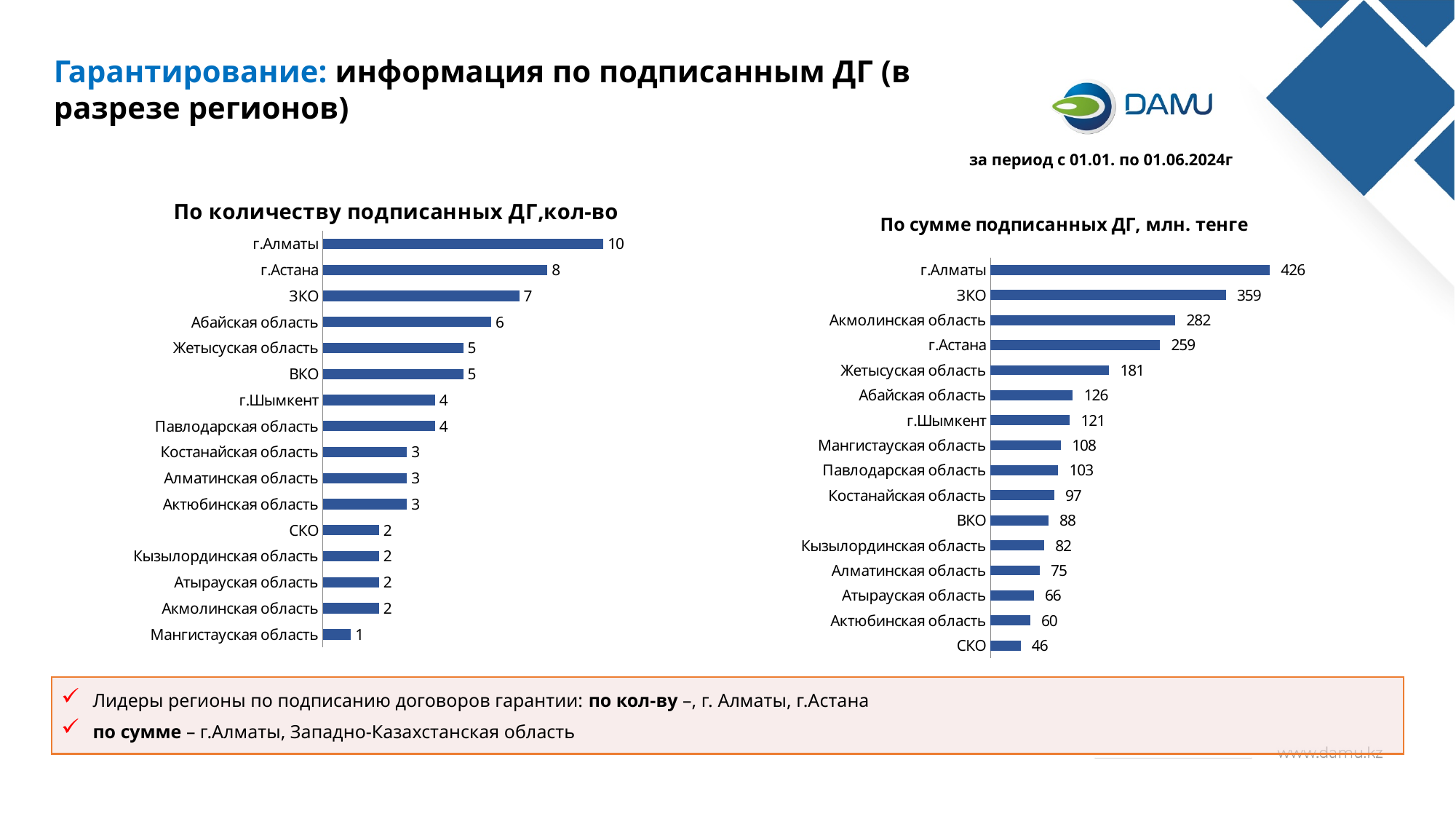
In the chart 'По сумме подписанных ДГ, млн. тенге', which region has the highest value? г.Алматы In the chart 'По сумме подписанных ДГ, млн. тенге', which is larger: Жетысуская область or Абайская область? Жетысуская область How many regions are shown in the chart 'По сумме подписанных ДГ, млн. тенге'? 16 What type of chart is 'По количеству подписанных ДГ,кол-во'? Bar chart In the chart 'По сумме подписанных ДГ, млн. тенге', what is the value for ВКО? 88 In the chart 'По сумме подписанных ДГ, млн. тенге', what is the difference between г.Алматы and ЗКО? 67 In the chart 'По количеству подписанных ДГ,кол-во', which is larger: Абайская область or г.Шымкент? Абайская область In the chart 'По количеству подписанных ДГ,кол-во', what is the difference between г.Алматы and ЗКО? 3 In the chart 'По сумме подписанных ДГ, млн. тенге', which region has the lowest value? СКО In the chart 'По количеству подписанных ДГ,кол-во', which region has the lowest value? Мангистауская область In the chart 'По количеству подписанных ДГ,кол-во', what is the value for г.Астана? 8 In the chart 'По сумме подписанных ДГ, млн. тенге', what is the value for Акмолинская область? 282